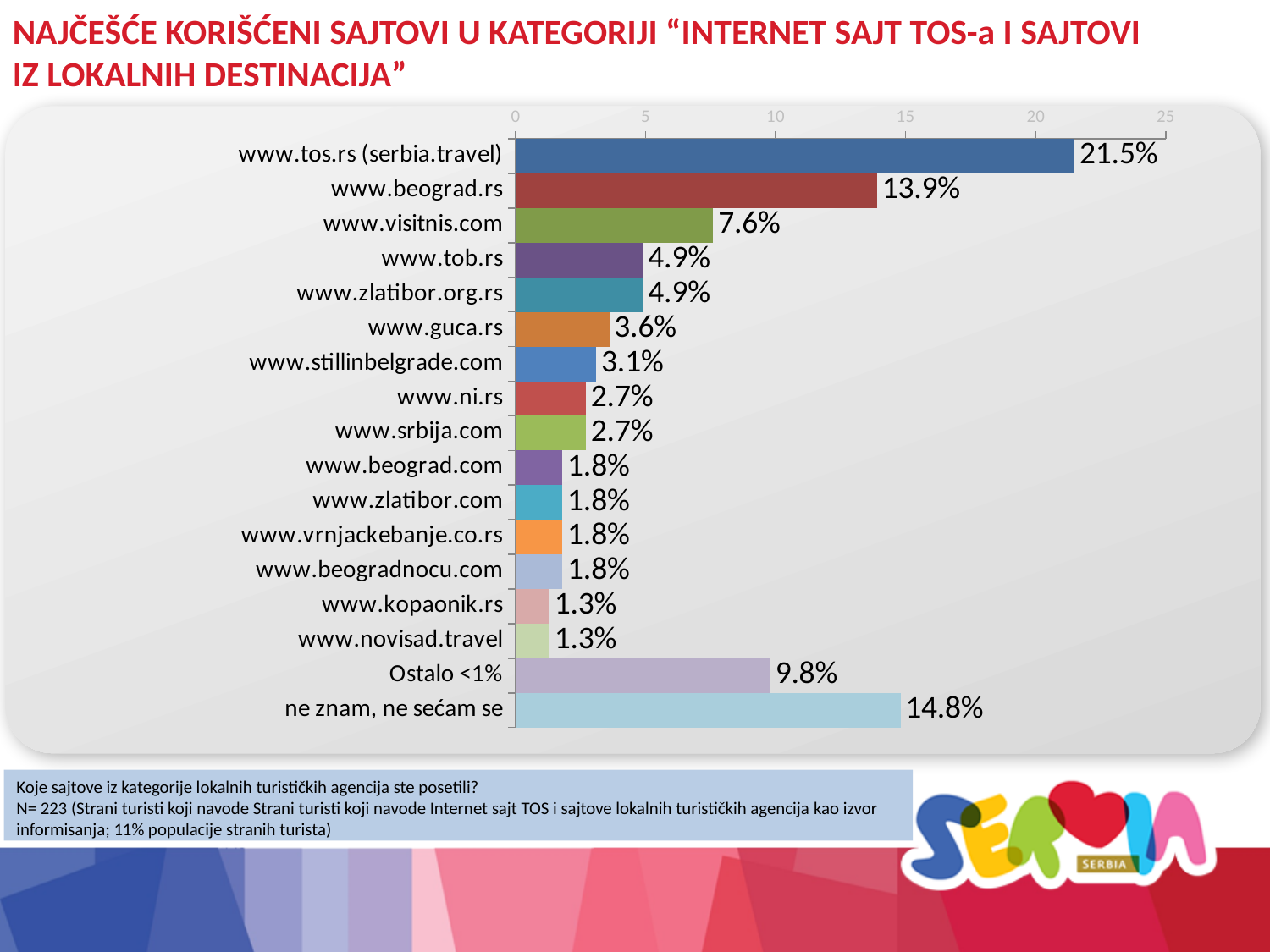
What is the value for "Ostalo <1%"? 9.8% What is the difference between the values for www.visitnis.com and www.tob.rs? 2.7% What is the value for www.tos.rs (serbia.travel)? 21.5% What is the value for www.beograd.rs? 13.9% What is the value for www.visitnis.com? 7.6% What is the value for "ne znam, ne sećam se"? 14.8% How many categories are shown in the chart? 17 Which category has the highest value? www.tos.rs (serbia.travel) Which is larger, the value for www.beograd.rs or the value for "ne znam, ne sećam se"? ne znam, ne sećam se What kind of chart is shown on the slide? bar chart What is the difference between the values for www.tos.rs (serbia.travel) and www.beograd.rs? 7.6% Which is larger, the value for www.guca.rs or the value for www.stillinbelgrade.com? www.guca.rs